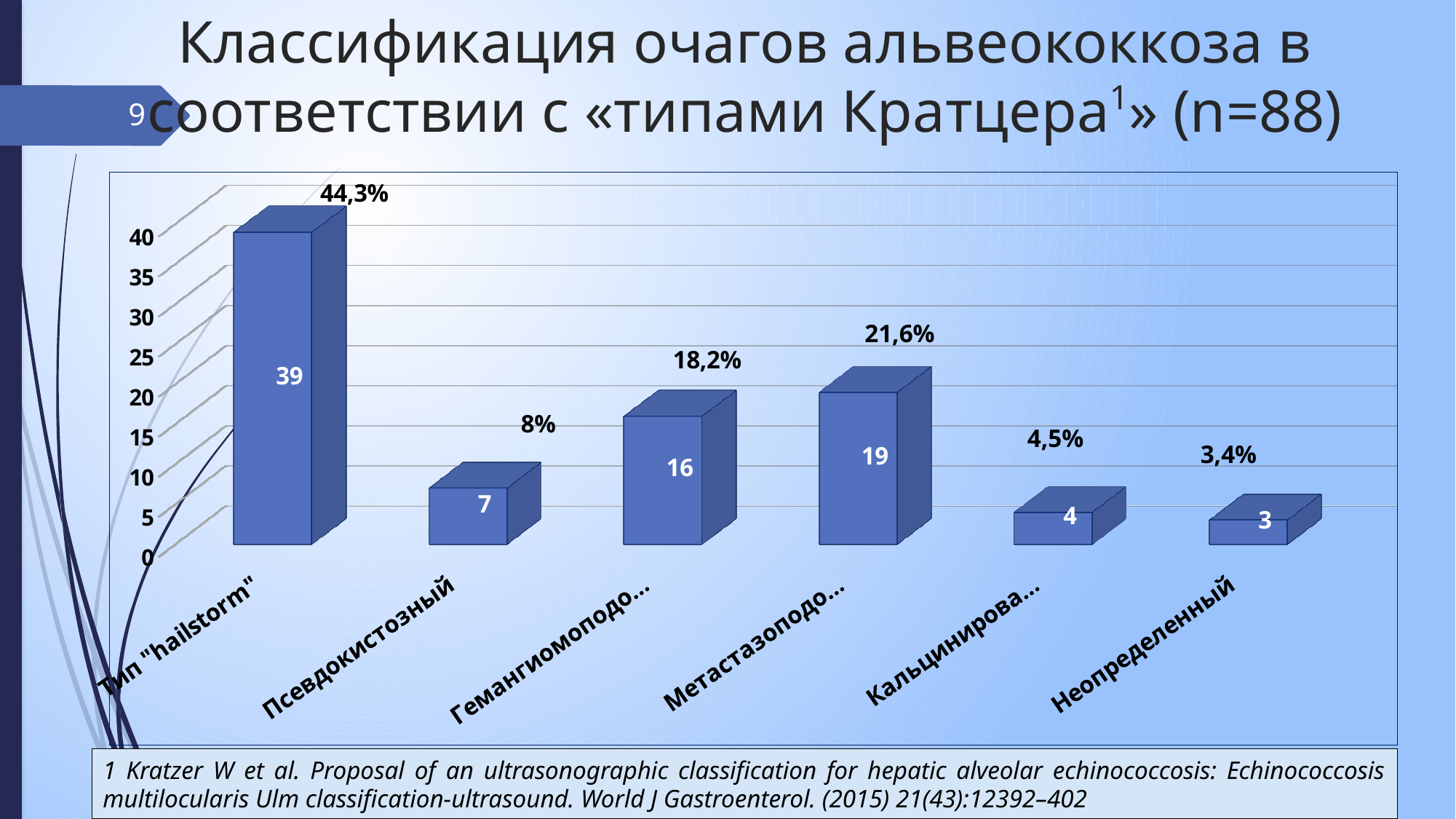
What is the difference between the values for Тип "hailstorm" and Псевдокистозный? 32 Which category has the lowest value? Неопределенный What percentage is shown above the tallest bar? 44,3% Which is larger, the value for Метастазоподо... or the value for Гемангиомоподо...? Метастазоподо... What is the value shown for the category Неопределенный? 3 What is the value shown for the category Тип "hailstorm"? 39 What percentage is shown above the bar for Неопределенный? 3,4% Is the value for Псевдокистозный greater or less than 10? less Which category has the highest value? Тип "hailstorm" How many categories are shown on the chart? 6 What percentage is shown above the bar for Псевдокистозный? 8% What kind of chart is shown on the slide? bar chart